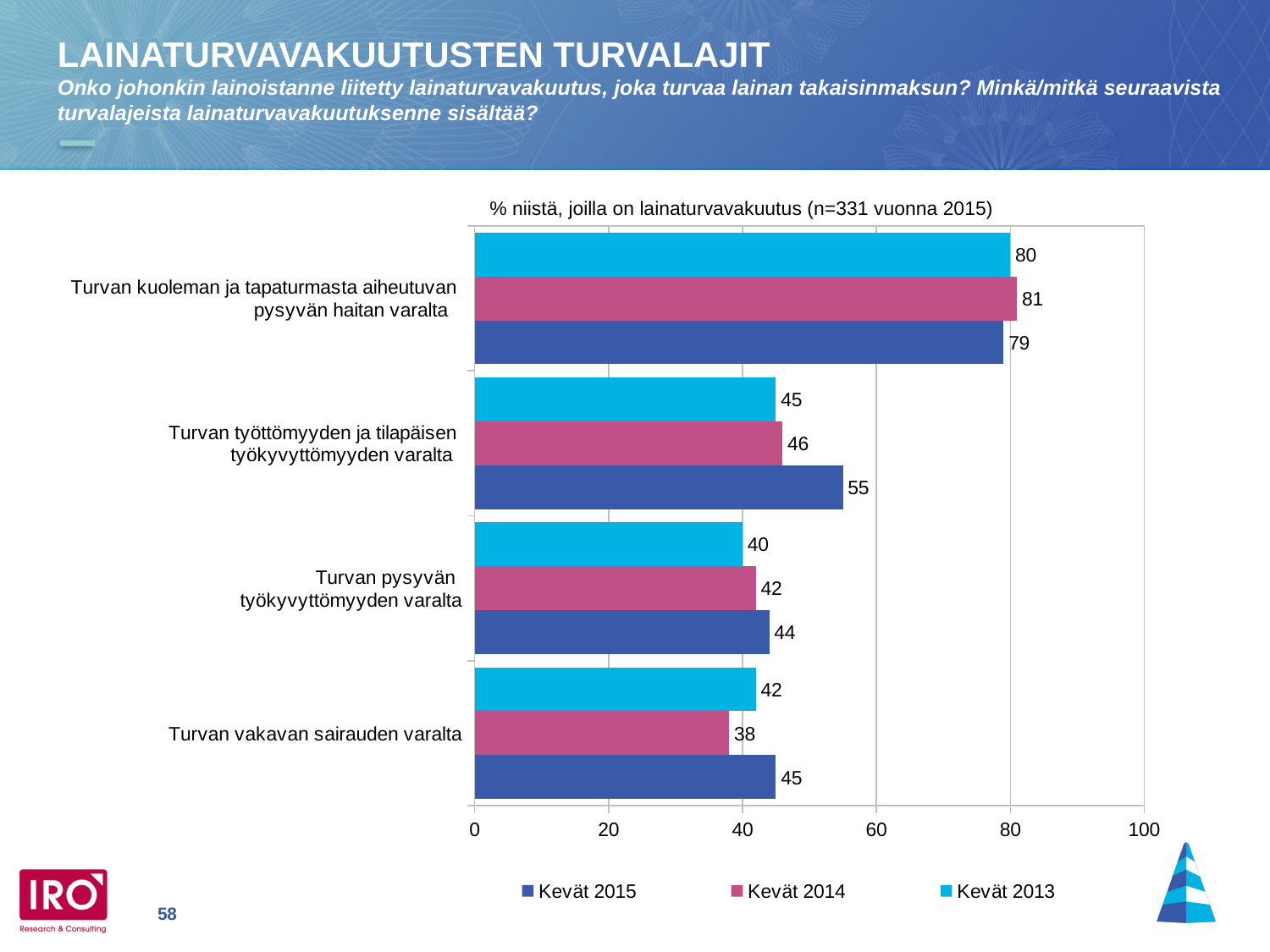
What kind of chart is shown on the slide? Bar chart For 'Turvan vakavan sairauden varalta', which is larger: the Kevät 2013 value or the Kevät 2014 value? Kevät 2013 Which series is shown in pink in the legend? Kevät 2014 Which category has the highest value for Kevät 2015? Turvan kuoleman ja tapaturmasta aiheutuvan pysyvän haitan varalta What is the value for Kevät 2014 for 'Turvan vakavan sairauden varalta'? 38 How many categories are shown on the chart? 4 What is the value for Kevät 2015 for 'Turvan työttömyyden ja tilapäisen työkyvyttömyyden varalta'? 55 How many series does the legend list? 3 What is the difference between the Kevät 2015 and Kevät 2014 values for 'Turvan työttömyyden ja tilapäisen työkyvyttömyyden varalta'? 9 What is the value for Kevät 2013 for 'Turvan pysyvän työkyvyttömyyden varalta'? 40 What is the title shown above the chart? % niistä, joilla on lainaturvavakuutus (n=331 vuonna 2015) Which category has the lowest value for Kevät 2014? Turvan vakavan sairauden varalta